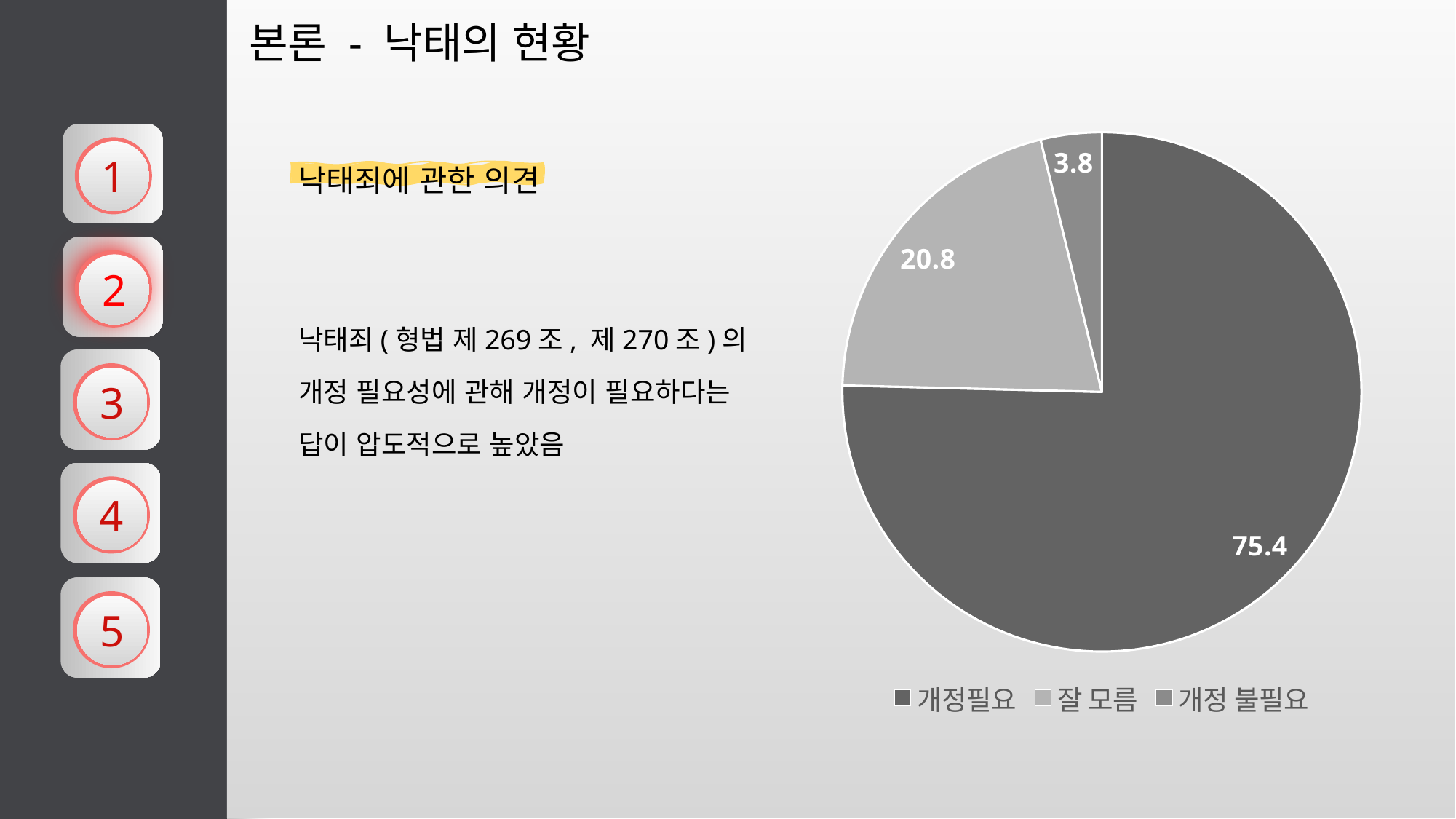
Which legend entry is shown with the lightest grey colour? 잘 모름 What is the difference between the values for 잘 모름 and 개정 불필요? 17 How many slices does the pie chart have? 3 Which is larger, the value for 잘 모름 or the value for 개정 불필요? 잘 모름 What is the value for 잘 모름? 20.8 What is the value for 개정필요? 75.4 What is the value for 개정 불필요? 3.8 Which category has the smallest slice? 개정 불필요 How many entries does the legend list? 3 What kind of chart is shown on the slide? pie chart What is the difference between the values for 개정필요 and 잘 모름? 54.6 Which category has the largest slice? 개정필요